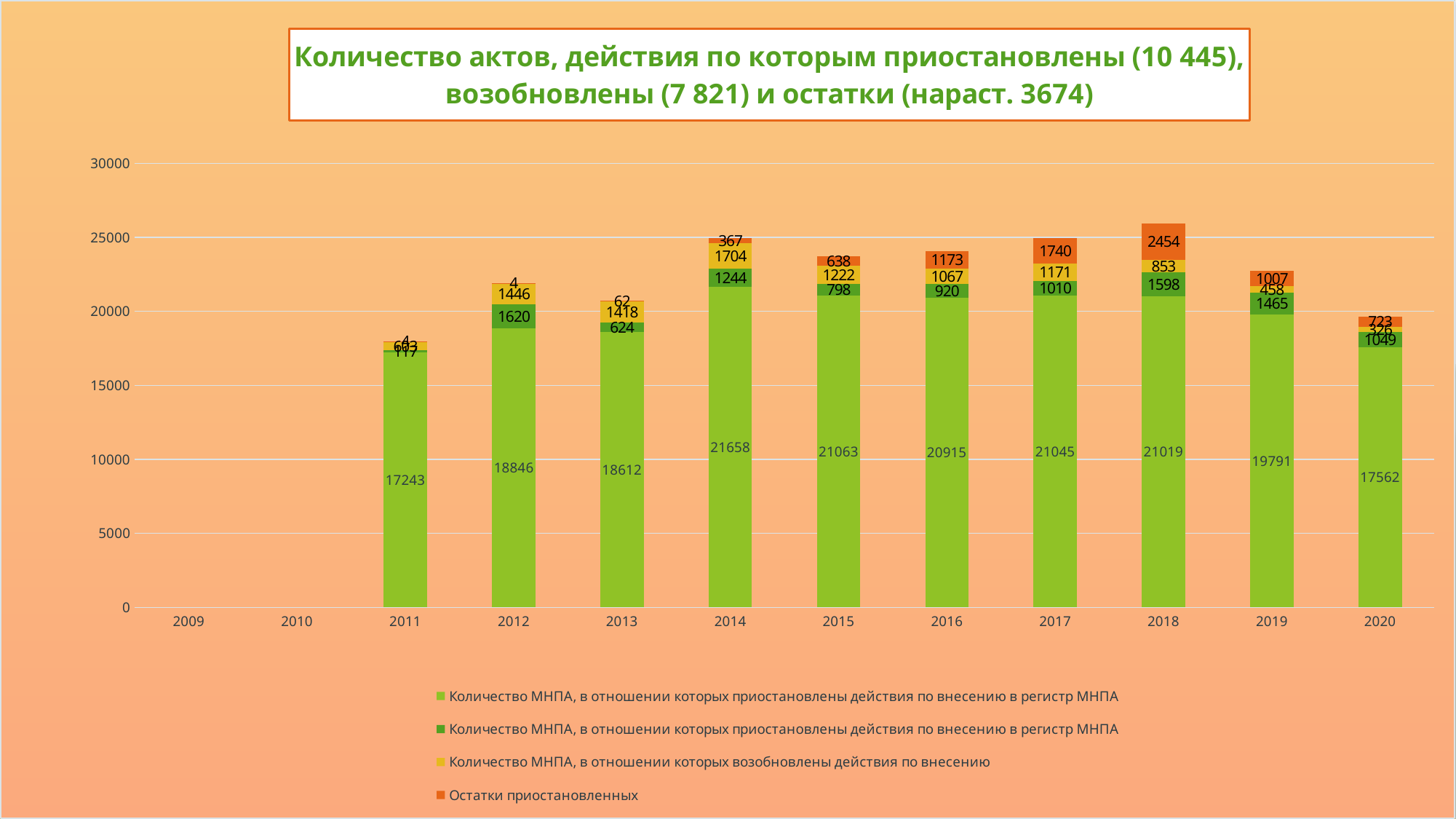
What is the total of the stacked bar for 2020? 19660 What is the value of the dark green segment for 2012? 1620 What is the value of the light green (bottom) segment for 2014? 21658 What is the value of 'Остатки приостановленных' for 2018? 2454 What is the value of the yellow segment ('возобновлены действия по внесению') for 2013? 1418 Which year has the larger 'Остатки приостановленных' value, 2017 or 2019? 2017 In which year is 'Остатки приостановленных' the highest? 2018 What is the difference between the light green segment values for 2014 and 2020? 4096 Is the total height of the 2018 bar greater or less than 25000? greater How many series does the legend list? 4 What kind of chart is shown on the slide? Stacked bar chart In which year is the light green (bottom) segment the lowest? 2011